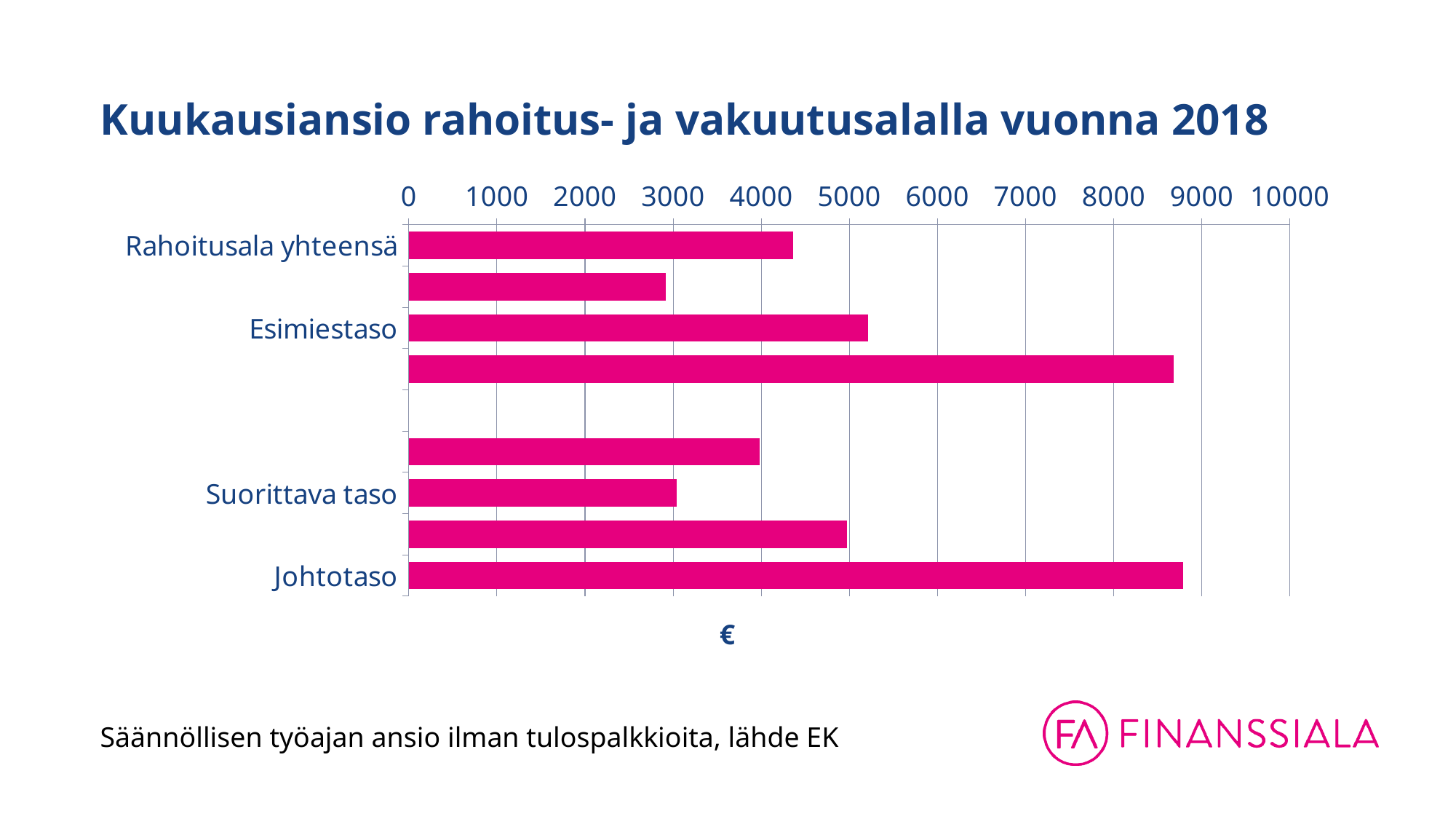
Is the value of the bar labelled Suorittava taso greater or less than 4000? less What unit is shown on the horizontal axis of the chart? € Is the value of the bar labelled Esimiestaso greater or less than 5000? greater How many bars are plotted in the chart? 8 What is the title of the chart? Kuukausiansio rahoitus- ja vakuutusalalla vuonna 2018 What is the highest value shown on the horizontal axis of the chart? 10000 What kind of chart is shown on the slide? bar chart Is the value of the bar labelled Rahoitusala yhteensä greater or less than 5000? less Which is larger, the bar labelled Johtotaso or the bar labelled Esimiestaso? Johtotaso Which is larger, the bar labelled Rahoitusala yhteensä or the bar labelled Suorittava taso? Rahoitusala yhteensä